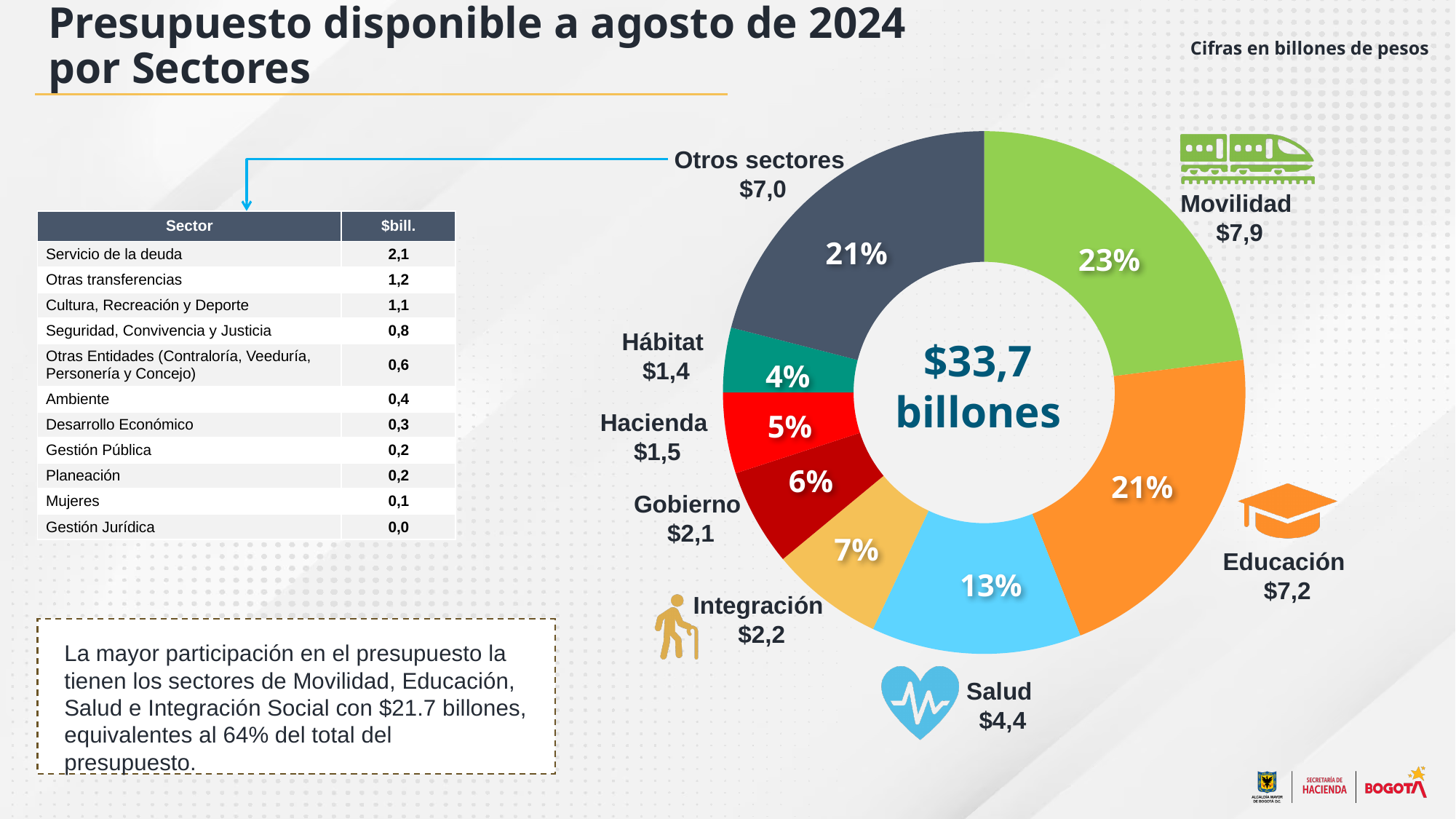
What is the value shown for Hábitat? $1,4 Which is larger, the value for Gobierno or the value for Hacienda? Gobierno How many slices does the chart have? 8 Which sector has the largest share of the budget in the chart? Movilidad What is the value shown for Movilidad? $7,9 What is the difference between the values for Movilidad and Educación? $0,7 What percentage share does Salud have in the chart? 13% Which sector has the smallest share in the chart? Hábitat What is the value shown for Integración? $2,2 What percentage share does Otros sectores have in the chart? 21% What total is shown in the centre of the chart? $33,7 billones What kind of chart is shown on the slide? Pie chart (donut)